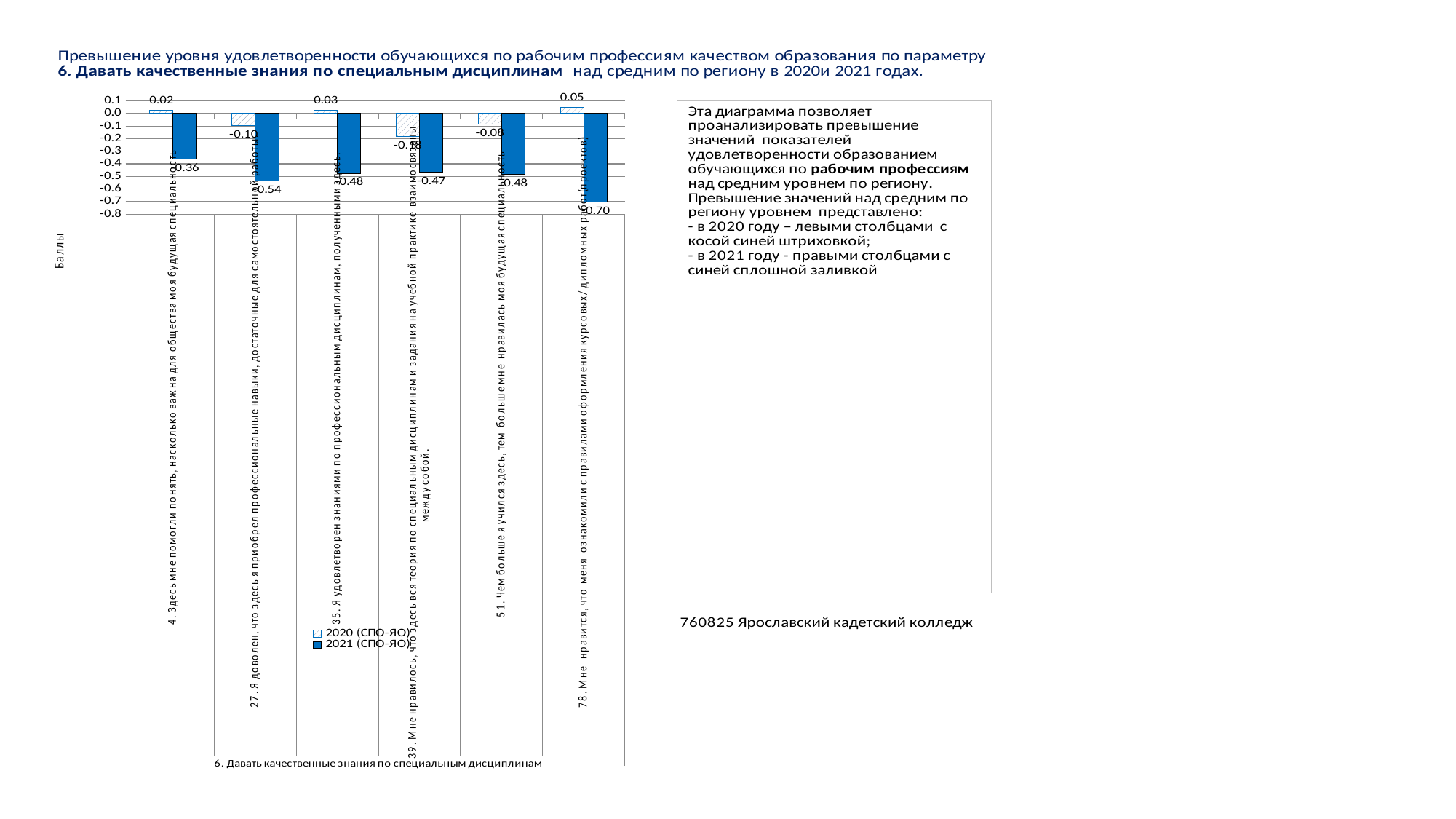
Which category has the highest 2020 (СПО-ЯО) value? 78. Мне нравится, что меня ознакомили с правилами оформления курсовых/дипломных работ (проектов) What type of chart is shown on the slide? Bar chart What is the 2021 (СПО-ЯО) value for category 4 (Здесь мне помогли понять, насколько важна для общества моя будущая специальность)? -0.36 What is the 2020 (СПО-ЯО) value for category 35 (Я удовлетворен знаниями по профессиональным дисциплинам, полученными здесь)? 0.03 How many series does the chart legend list? 2 Which is larger: the 2021 value for category 4 or the 2021 value for category 27? Category 4 (-0.36) Which category has the lowest 2021 (СПО-ЯО) value? 78. Мне нравится, что меня ознакомили с правилами оформления курсовых/дипломных работ (проектов) What is the 2020 (СПО-ЯО) value for category 39 (Мне нравилось, что здесь вся теория по специальным дисциплинам и задания на учебной практике взаимосвязаны между собой)? -0.18 How many categories are shown on the x axis of the chart? 6 For category 78, what is the difference between the 2020 value (0.05) and the 2021 value (-0.70)? 0.75 What is the 2021 (СПО-ЯО) value for category 78 (Мне нравится, что меня ознакомили с правилами оформления курсовых/дипломных работ)? -0.70 For category 27 (Я доволен, что здесь я приобрел профессиональные навыки), what is the difference between the 2020 value and the 2021 value? 0.44